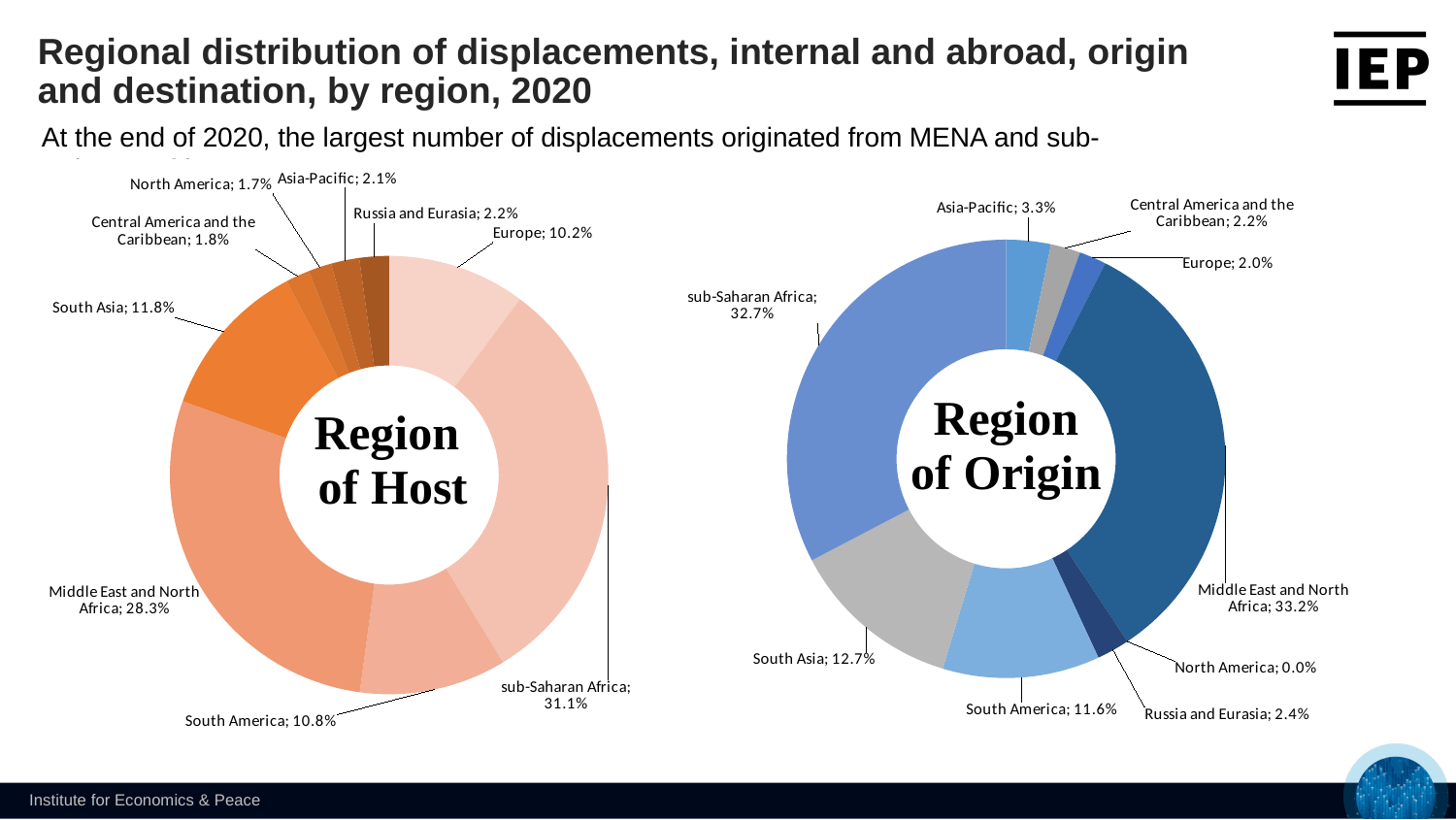
In the Region of Host chart, which region has the smallest share? North America In the Region of Host chart, which region has the largest share? sub-Saharan Africa In the Region of Host chart, what share of displacements is hosted by sub-Saharan Africa? 31.1% In the Region of Host chart, which is larger: the share for Europe or the share for South Asia? South Asia How many regions are shown in the Region of Origin chart? 9 In the Region of Origin chart, what is the share for Russia and Eurasia? 2.4% In the Region of Origin chart, which region has the smallest share? North America What is the text shown in the centre of the right-hand chart? Region of Origin What type of chart is the Region of Host chart? Doughnut (pie) chart In the Region of Origin chart, what share of displacements originated from the Middle East and North Africa? 33.2% In the Region of Host chart, what is the share for South America? 10.8% In the Region of Origin chart, what is the difference between the shares of sub-Saharan Africa and South Asia? 20.0%